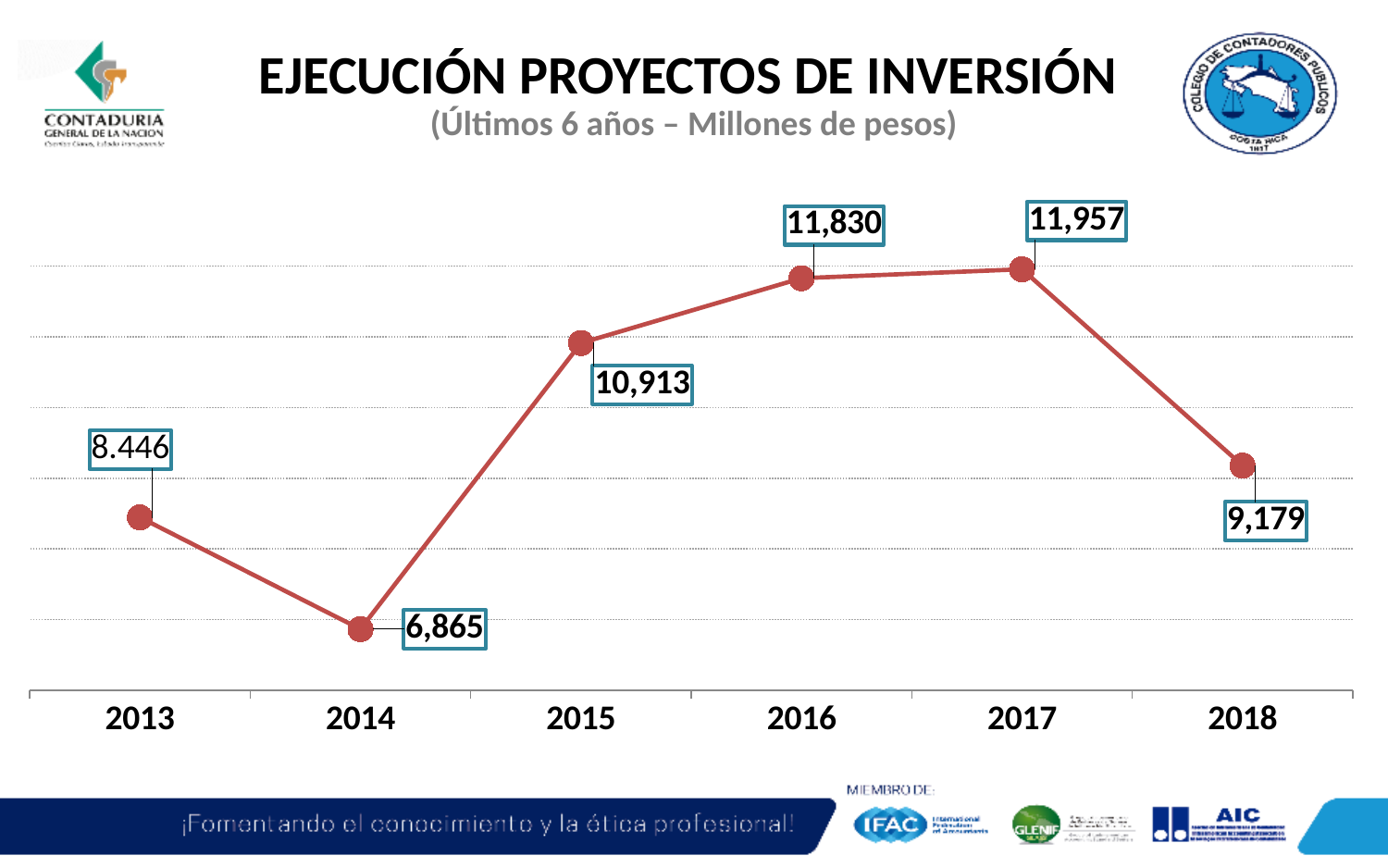
Which year has the highest value? 2017 Which year has the lowest value? 2014 Which is larger, the value for 2013 or the value for 2014? 2013 What kind of chart is shown on the slide? Line chart What is the value for 2014? 6,865 How many years are plotted on the chart? 6 What is the difference between the values for 2017 and 2016? 127 What is the value for 2018? 9,179 What is the value for 2016? 11,830 Does the value rise or fall from 2017 to 2018? Fall What is the difference between the values for 2015 and 2014? 4,048 What is the value for 2015? 10,913